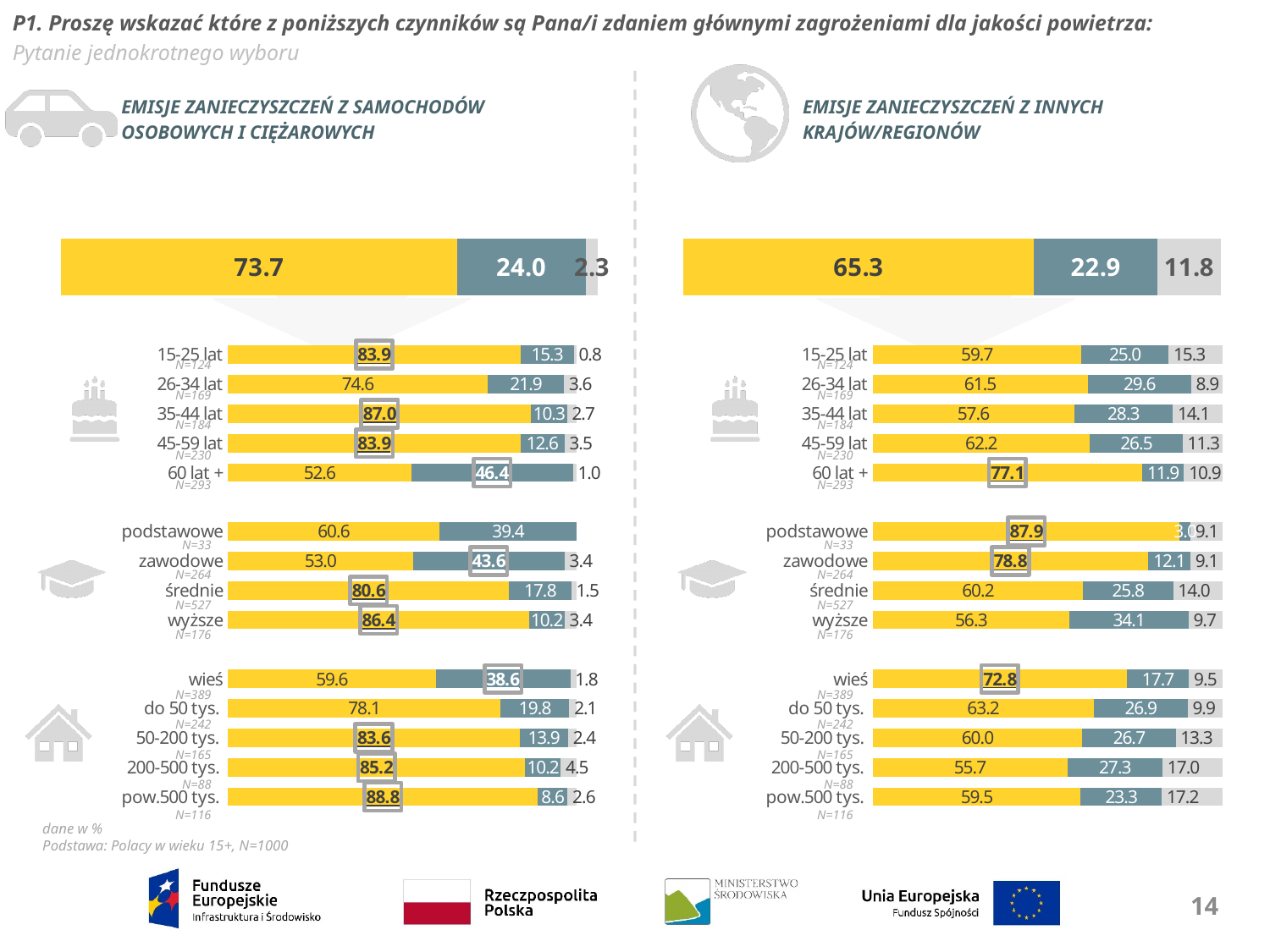
In the left chart, what is the difference between the yellow segment values for 35-44 lat and 60 lat +? 34.4 In the right chart, which has a larger yellow segment value: wieś or do 50 tys.? wieś In the left chart, what is the total of the three segments in the overall bar at the top? 100.0 In the right chart, what is the value of the dark grey (middle) segment for the wyższe education group? 34.1 What type of chart is used on this slide? Stacked bar chart In the right chart (Emisje zanieczyszczeń z innych krajów/regionów), what is the value of the light grey segment in the overall bar at the top? 11.8 In the left chart, what is the yellow segment value for the 60 lat + age group? 52.6 In the right chart, what is the yellow segment value for the podstawowe education group? 87.9 In the left chart, which locality category has the highest yellow segment value? pow.500 tys. In the left chart (Emisje zanieczyszczeń z samochodów osobowych i ciężarowych), what is the value of the yellow segment in the overall bar at the top? 73.7 In the right chart, which age group has the lowest yellow segment value? 35-44 lat How many age group categories are shown in the left chart? 5